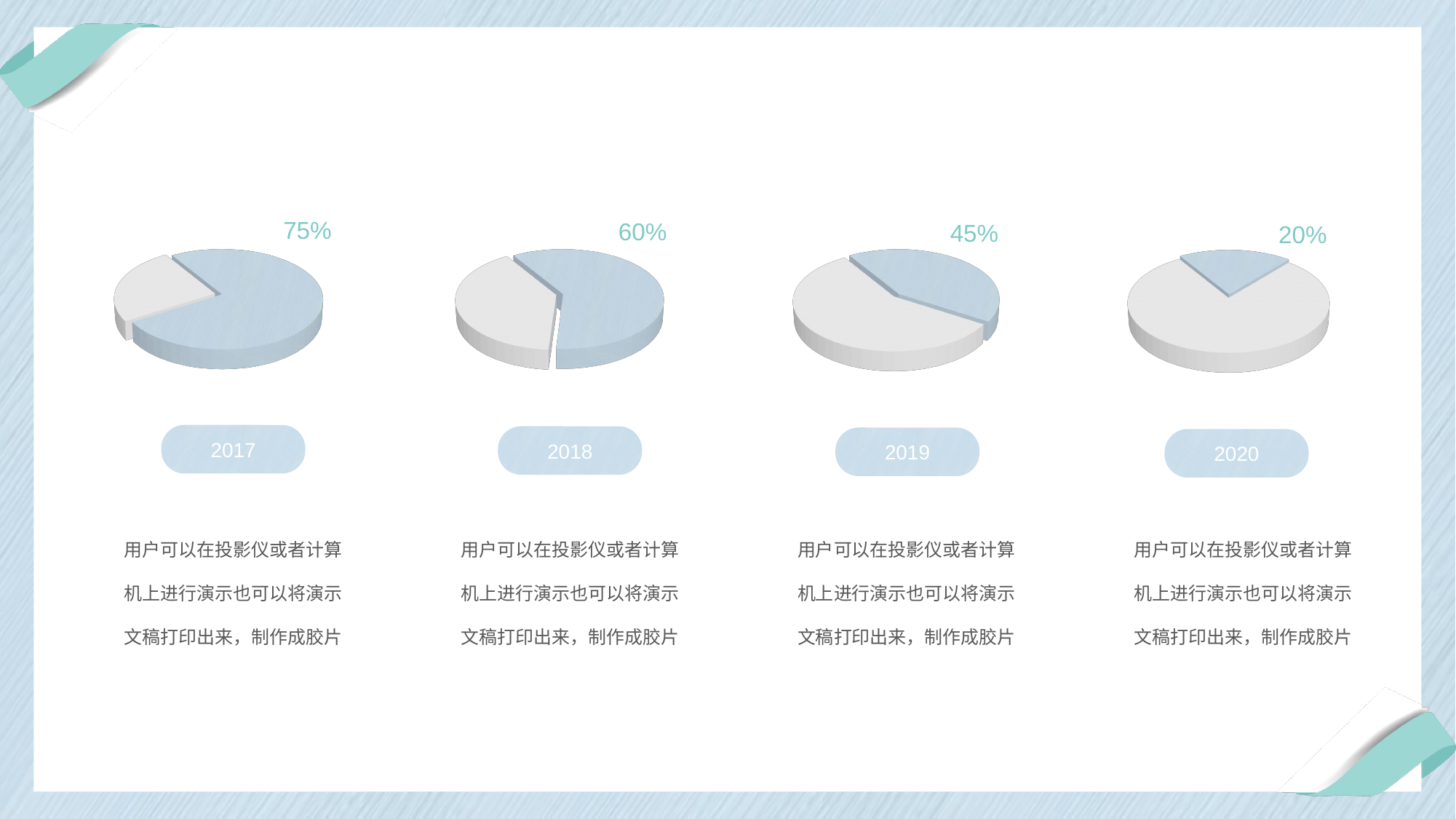
What is the difference between the percentage shown for 2017 and the percentage shown for 2020? 55% What percentage is shown above the 2017 pie chart? 75% Which year's pie chart shows the highest percentage? 2017 Which year's pie chart shows the lowest percentage? 2020 What percentage is shown above the 2020 pie chart? 20% What kind of chart is used for each year on the slide? Pie chart Which is larger, the percentage shown for 2018 or the percentage shown for 2019? 2018 Do the percentages rise or fall from 2017 to 2020? Fall How many pie charts are on the slide? 4 In the 2020 pie chart, what share of the pie does the blue slice represent? 20% What percentage is shown above the 2019 pie chart? 45% What percentage is shown above the 2018 pie chart? 60%